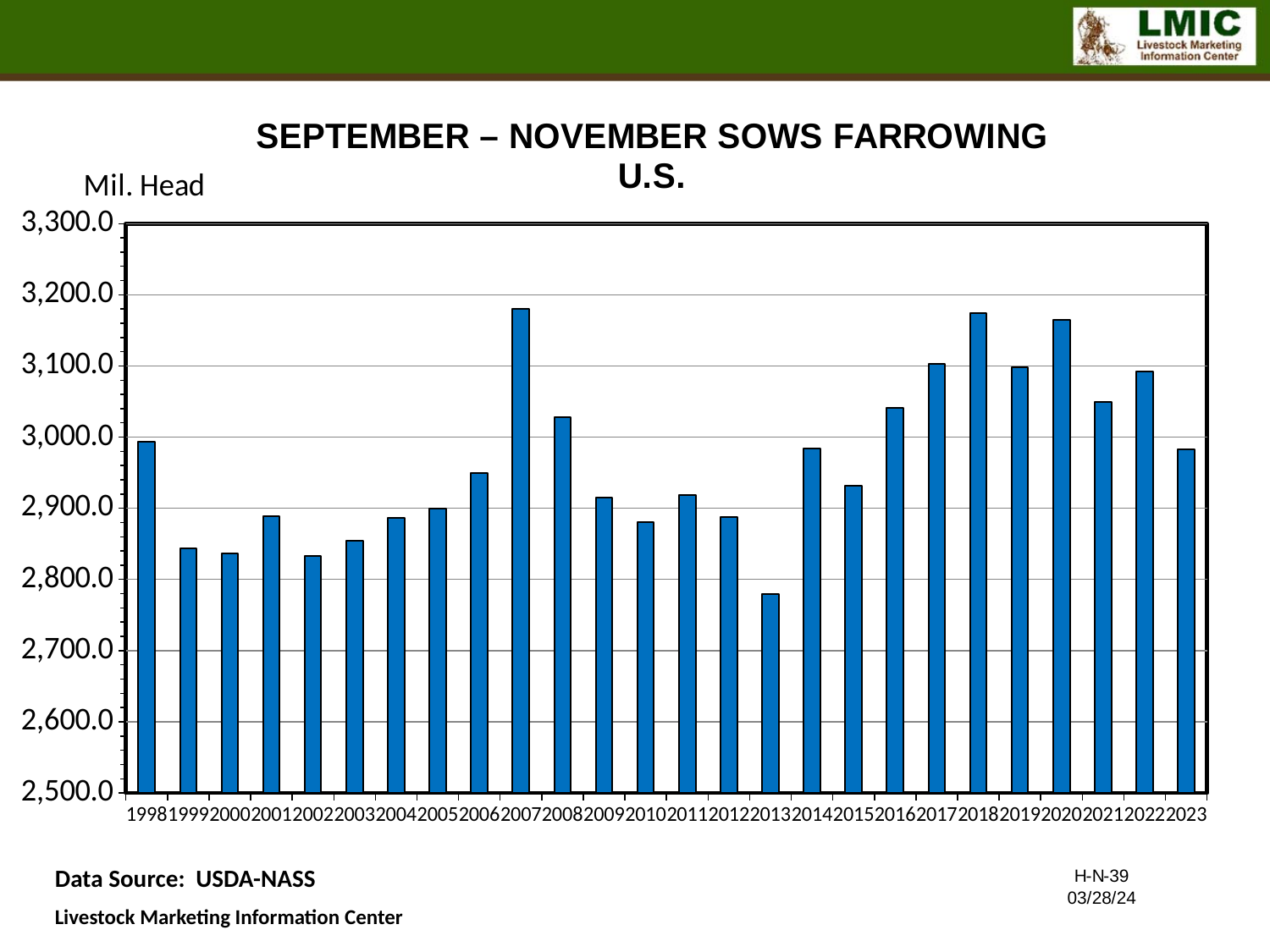
Is the value for 2002 greater or less than 2,900.0? less How many years (bars) are plotted on the chart? 26 Which year has the lowest September–November sows farrowing value? 2013 Do the values generally rise or fall from 2013 to 2018? rise Which year has the larger value, 2015 or 2016? 2016 What unit is shown on the y axis of the chart? Mil. Head Is the value for 2007 greater or less than 3,100.0? greater What kind of chart is shown on the slide? bar chart Is the value for 2013 greater or less than 2,800.0? less Which year has the larger value, 1998 or 1999? 1998 Which year has the larger value, 2007 or 2013? 2007